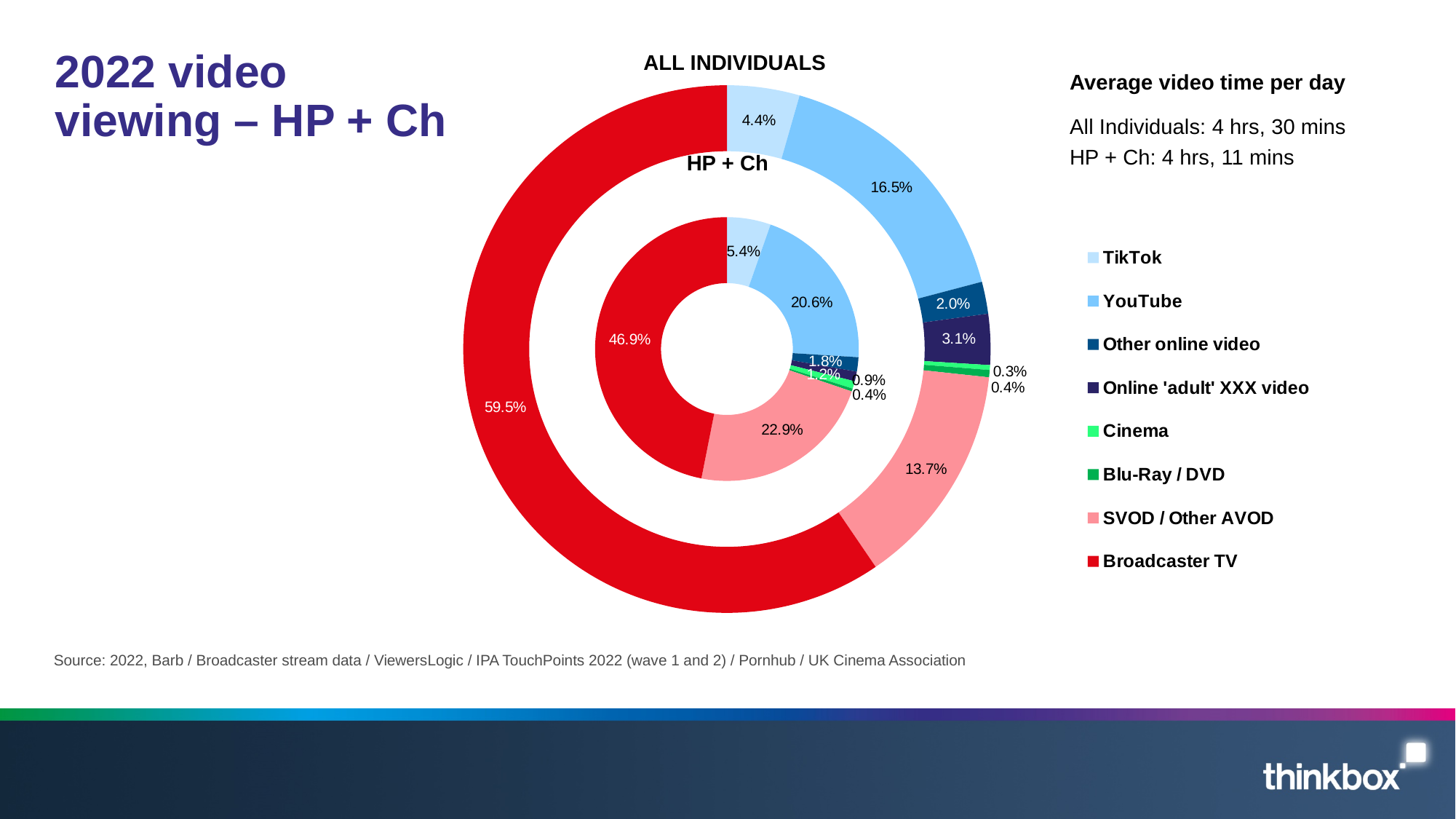
According to the slide, what is the average video time per day for HP + Ch? 4 hrs, 11 mins In the HP + Ch ring, what share of video viewing is YouTube? 20.6% In the ALL INDIVIDUALS ring, what share of video viewing is Broadcaster TV? 59.5% In the HP + Ch ring, what share of video viewing is Broadcaster TV? 46.9% In the ALL INDIVIDUALS ring, what share of video viewing is SVOD / Other AVOD? 13.7% In the ALL INDIVIDUALS ring, what share of video viewing is TikTok? 4.4% Which category has the largest share in the HP + Ch ring? Broadcaster TV What type of chart is shown on the slide? Doughnut chart How many categories does the legend list? 8 Which is larger: the YouTube share for ALL INDIVIDUALS or for HP + Ch? HP + Ch What is the difference between the Broadcaster TV share for ALL INDIVIDUALS and for HP + Ch? 12.6 percentage points What is the difference between the SVOD / Other AVOD share for HP + Ch and for ALL INDIVIDUALS? 9.2 percentage points